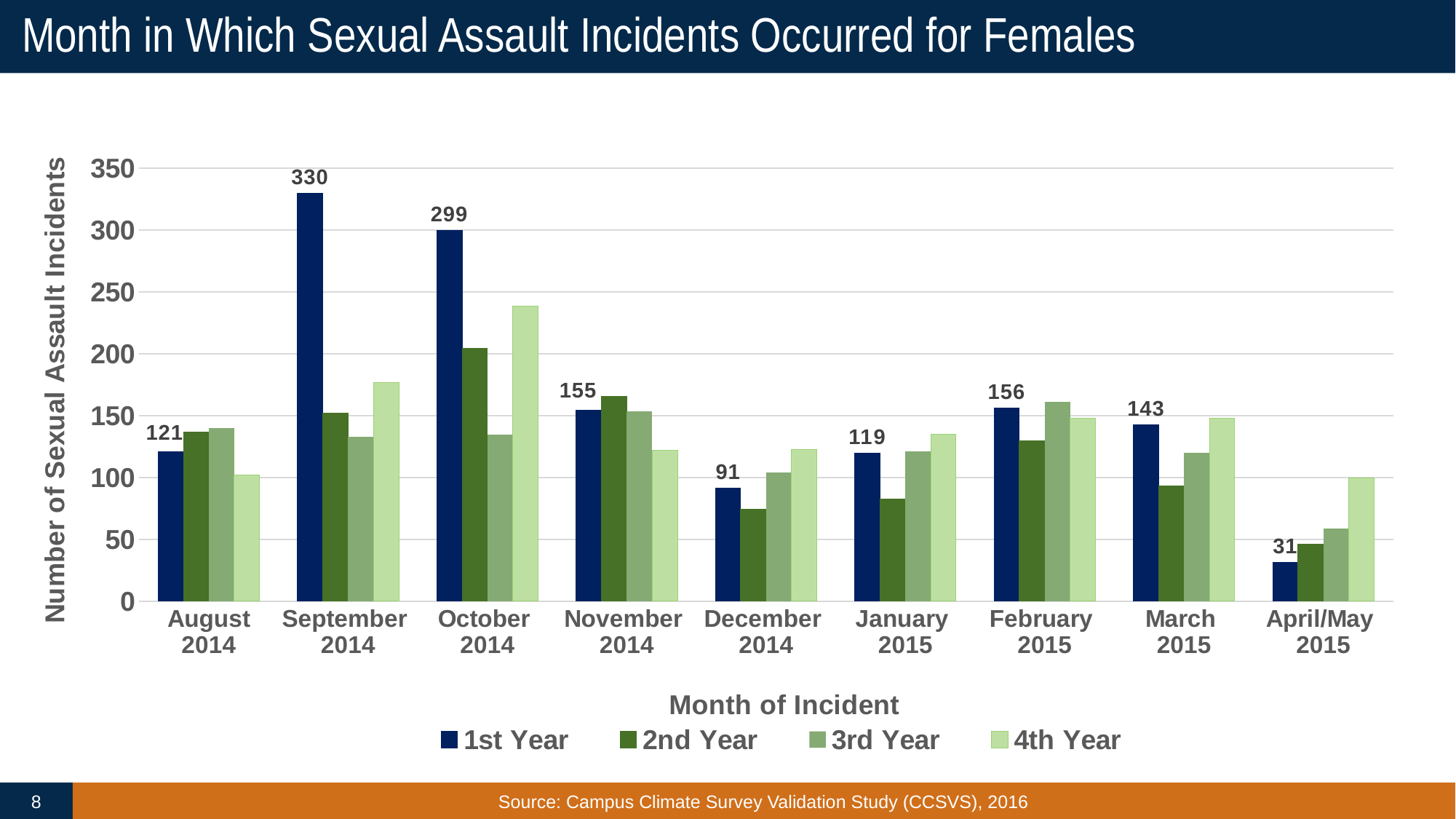
Do the 1st Year values rise or fall from October 2014 to December 2014? fall What is the number of sexual assault incidents for 1st Year students in April/May 2015? 31 Is the 2nd Year value for December 2014 greater or less than 100? less What is the number of sexual assault incidents for 1st Year students in September 2014? 330 Which is larger for 1st Year students: March 2015 or January 2015? March 2015 In which month is the 1st Year value lowest? April/May 2015 What is the difference between the 1st Year values for September 2014 and October 2014? 31 How many months are shown on the x axis? 9 How many series does the legend list? 4 Is the 4th Year value for October 2014 greater or less than 200? greater What is the number of sexual assault incidents for 1st Year students in December 2014? 91 In which month is the 1st Year value highest? September 2014